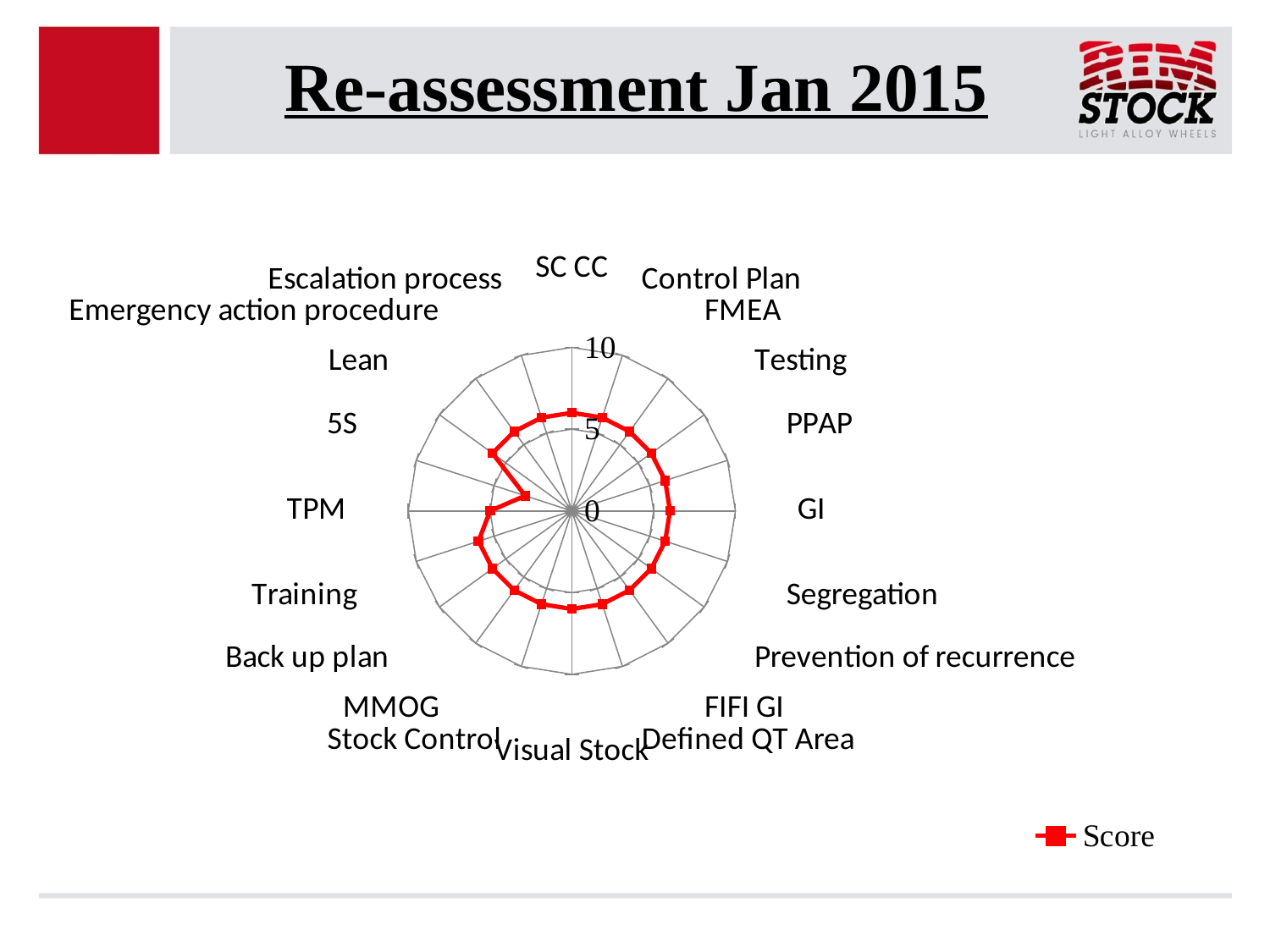
How many series does the legend list? 1 Which category has the lowest score on the radar chart? 5S What kind of chart is shown on the slide? radar chart Is the score for 5S greater or less than 5? less What is the name of the series shown in the legend? Score Which has the higher score, GI or TPM? GI Which has the higher score, Segregation or 5S? Segregation Is the score for Visual Stock greater or less than 5? greater What is the maximum value shown on the radar chart's axis scale? 10 How many categories are plotted on the radar chart? 20 Is the score for GI greater or less than 5? greater